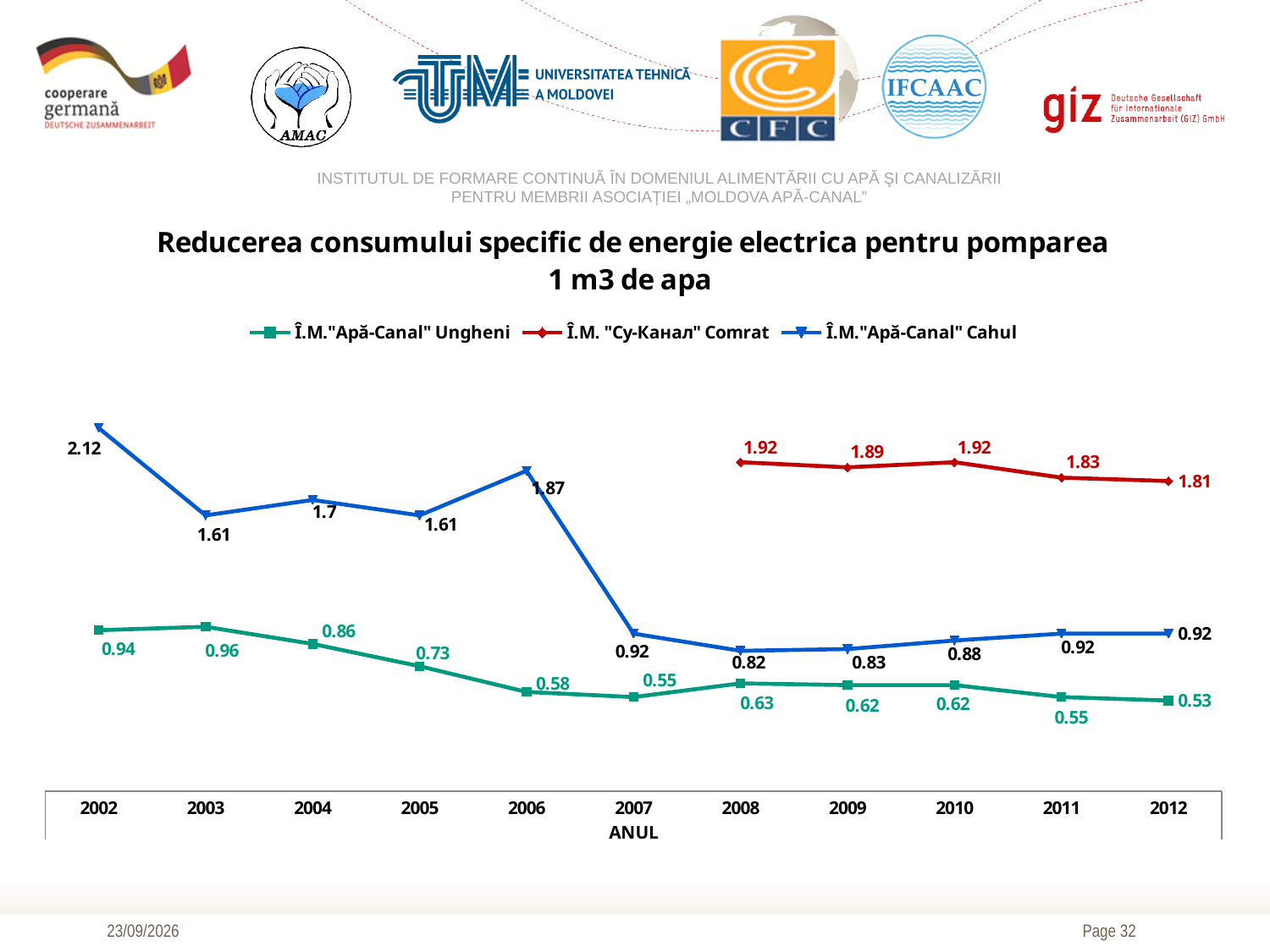
In which year is the value for Î.M."Apă-Canal" Ungheni lowest? 2012 How many years are shown on the x axis? 11 What is the value for Î.M."Apă-Canal" Ungheni in 2012? 0.53 What type of chart is shown on the slide? line chart What is the difference between the Cahul value in 2006 and the Cahul value in 2007? 0.95 Does the value for Î.M. "Су-Канал" Comrat rise or fall from 2010 to 2012? fall How many series does the legend list? 3 Which series has the larger value in 2010, Comrat or Cahul? Î.M. "Су-Канал" Comrat What is the label of the x axis? ANUL What is the value for Î.M. "Су-Канал" Comrat in 2009? 1.89 What is the value for Î.M."Apă-Canal" Cahul in 2002? 2.12 In which year is the value for Î.M."Apă-Canal" Cahul highest? 2002